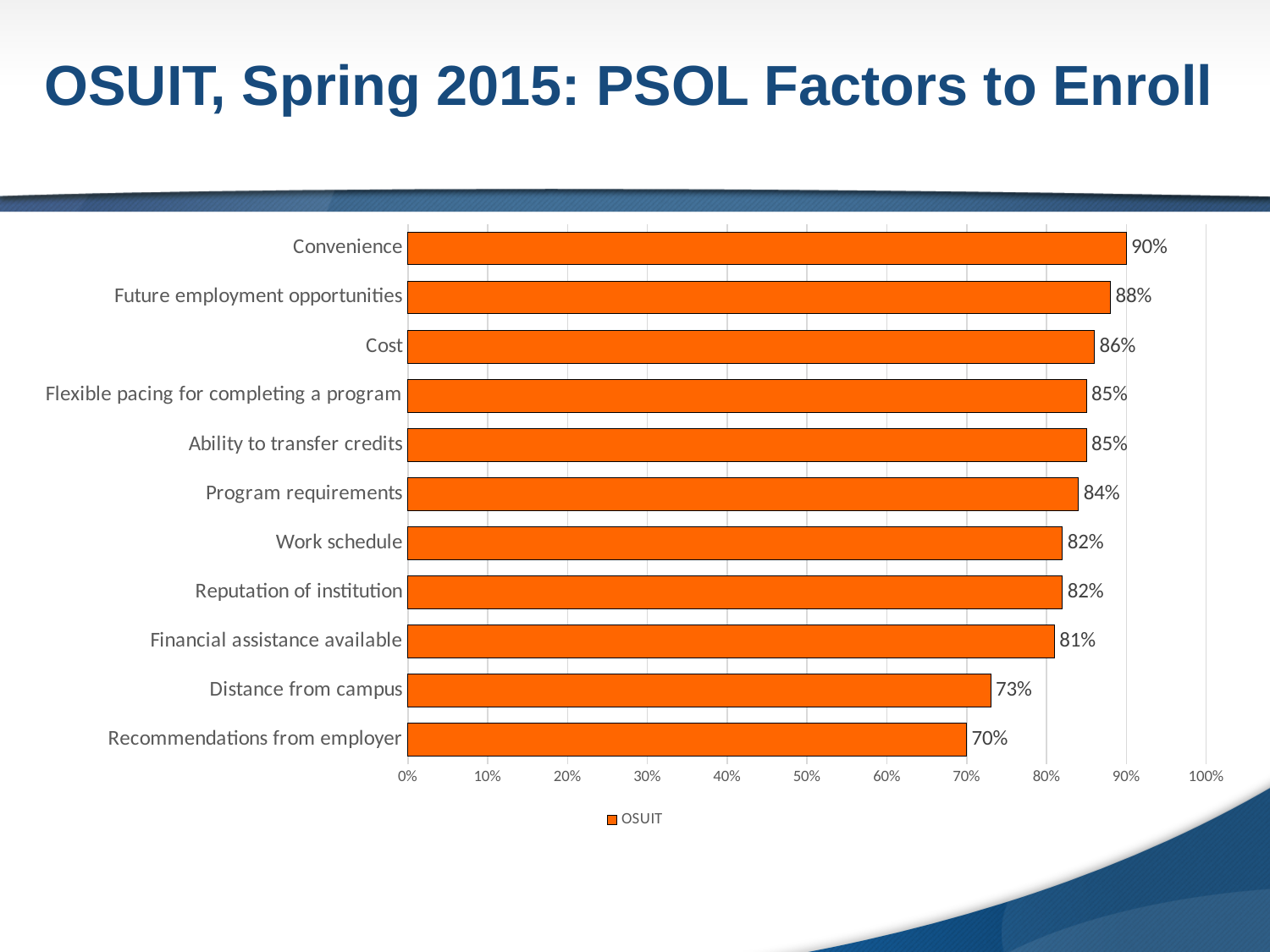
Which category has the highest value? Convenience Which category has the lowest value? Recommendations from employer What kind of chart is shown on the slide? Bar chart What is the difference between the values for Cost and Distance from campus? 13% What is the value for Distance from campus? 73% How many series does the legend list? 1 What is the difference between the values for Convenience and Recommendations from employer? 20% What series name is shown in the legend? OSUIT What is the value for Financial assistance available? 81% How many categories are shown in the chart? 11 Which is larger, the value for Future employment opportunities or the value for Program requirements? Future employment opportunities What is the value for Convenience? 90%